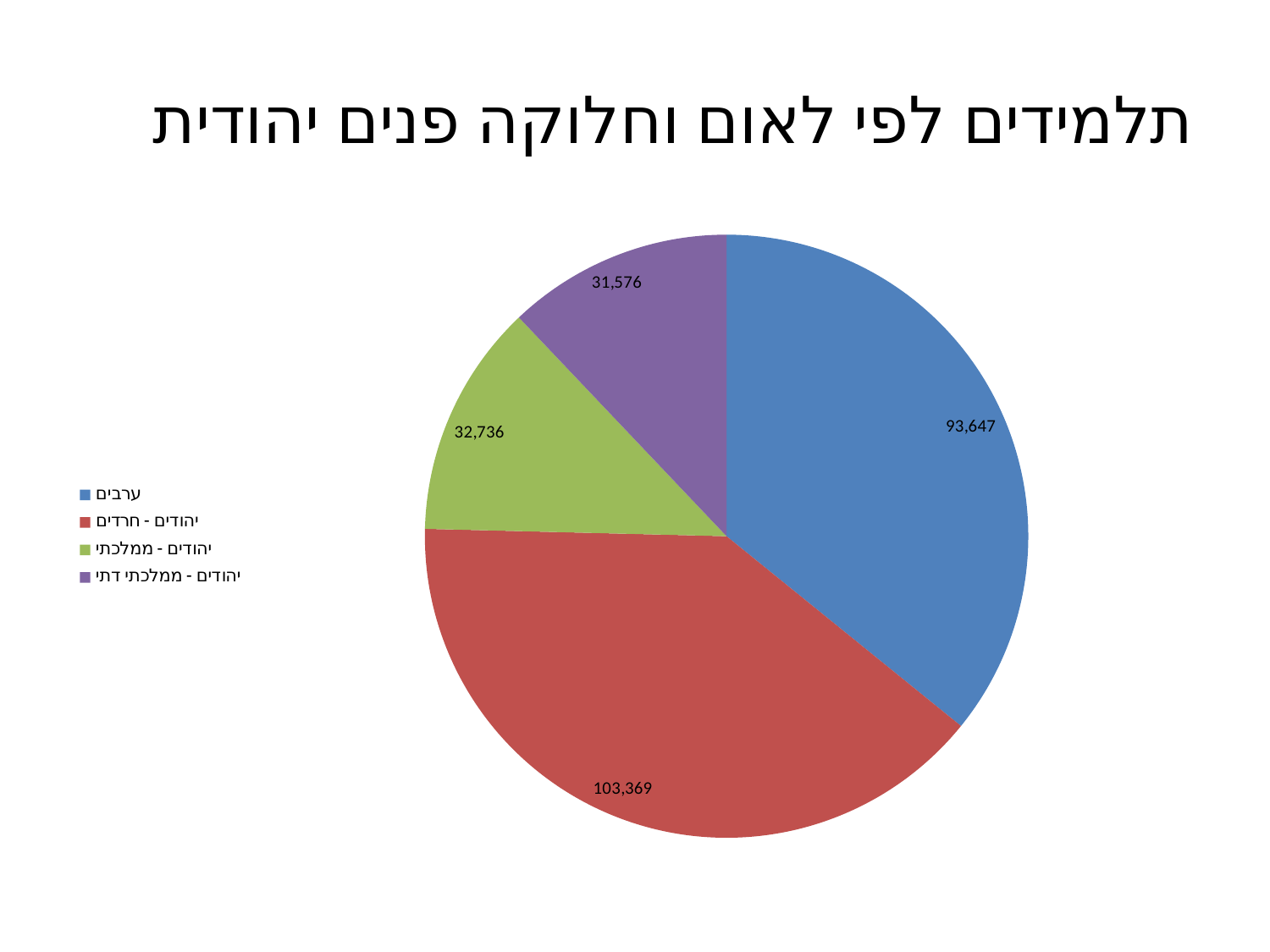
What is the value for יהודים - חרדים? 103,369 How many categories does the pie chart show? 4 What colour is the slice for יהודים - ממלכתי? Green Which is larger, the value for ערבים or the value for יהודים - ממלכתי? ערבים What kind of chart is shown on the slide? Pie chart What is the value for ערבים? 93,647 What is the difference between the values for יהודים - ממלכתי and יהודים - ממלכתי דתי? 1,160 Which category has the largest slice of the pie? יהודים - חרדים What is the value for יהודים - ממלכתי דתי? 31,576 What is the difference between the values for יהודים - חרדים and ערבים? 9,722 Which category has the smallest slice of the pie? יהודים - ממלכתי דתי What is the value for יהודים - ממלכתי? 32,736